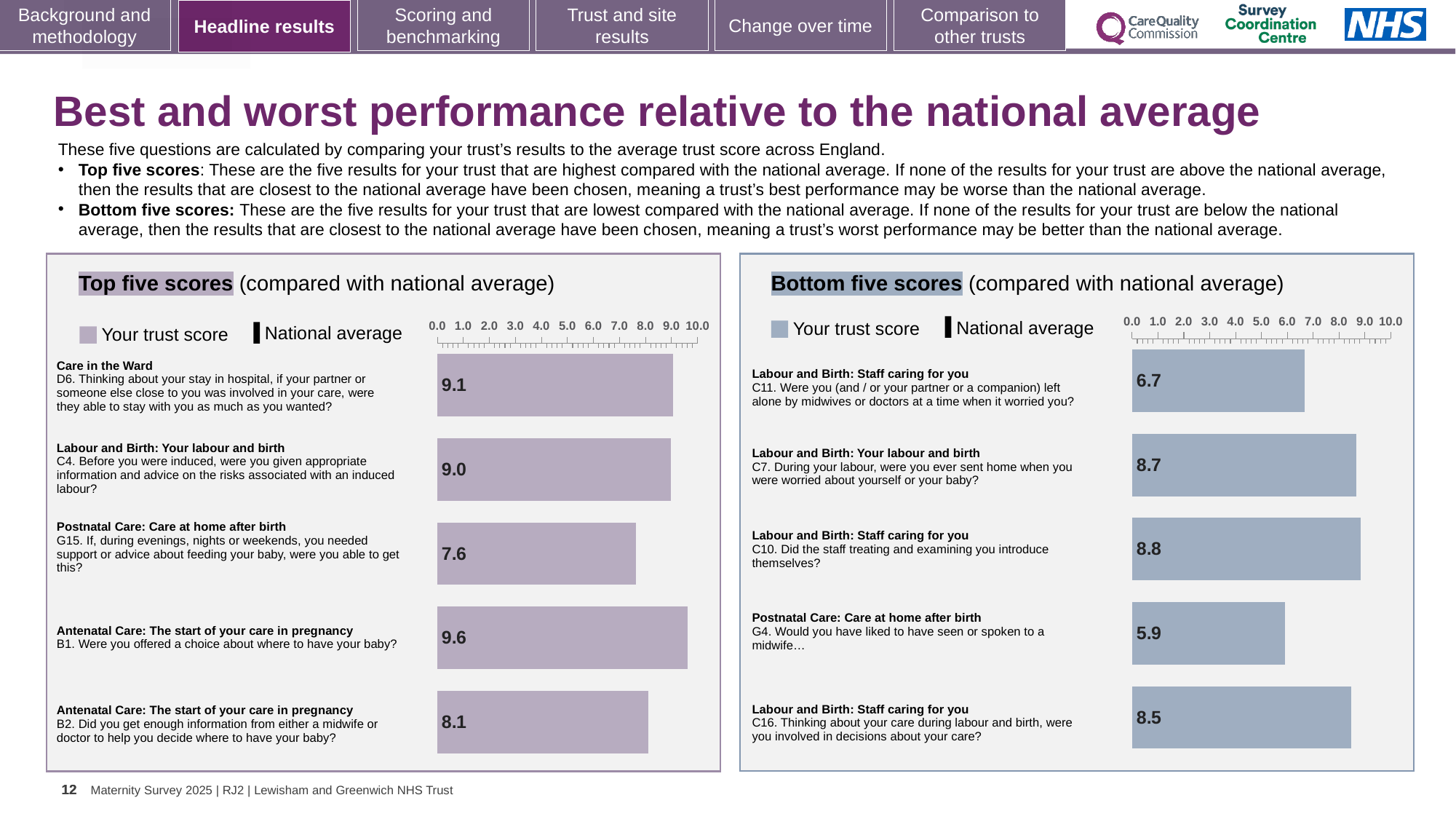
In the Bottom five scores chart, what is the trust score for C7 (During your labour, were you ever sent home when you were worried)? 8.7 In the Bottom five scores chart, what is the difference between the trust scores for C10 and C11? 2.1 In the Top five scores chart, which question has the lowest trust score? G15 (7.6) How many questions (bars) are shown in the Top five scores chart? 5 What type of chart is used in the Bottom five scores panel? Bar chart In the Top five scores chart, what is the trust score for D6 (partner or someone close able to stay with you as much as you wanted)? 9.1 In the Top five scores chart, what is the trust score for B1 (Were you offered a choice about where to have your baby?)? 9.6 In the Top five scores chart, what is the difference between the trust scores for B1 and G15? 2.0 In the Bottom five scores chart, what is the trust score for G4 (Would you have liked to have seen or spoken to a midwife…)? 5.9 In the Bottom five scores chart, which question has the lowest trust score? G4 (5.9) In the Top five scores chart, which question has the highest trust score? B1 (9.6) In the Bottom five scores chart, which has the larger trust score, C11 or C16? C16